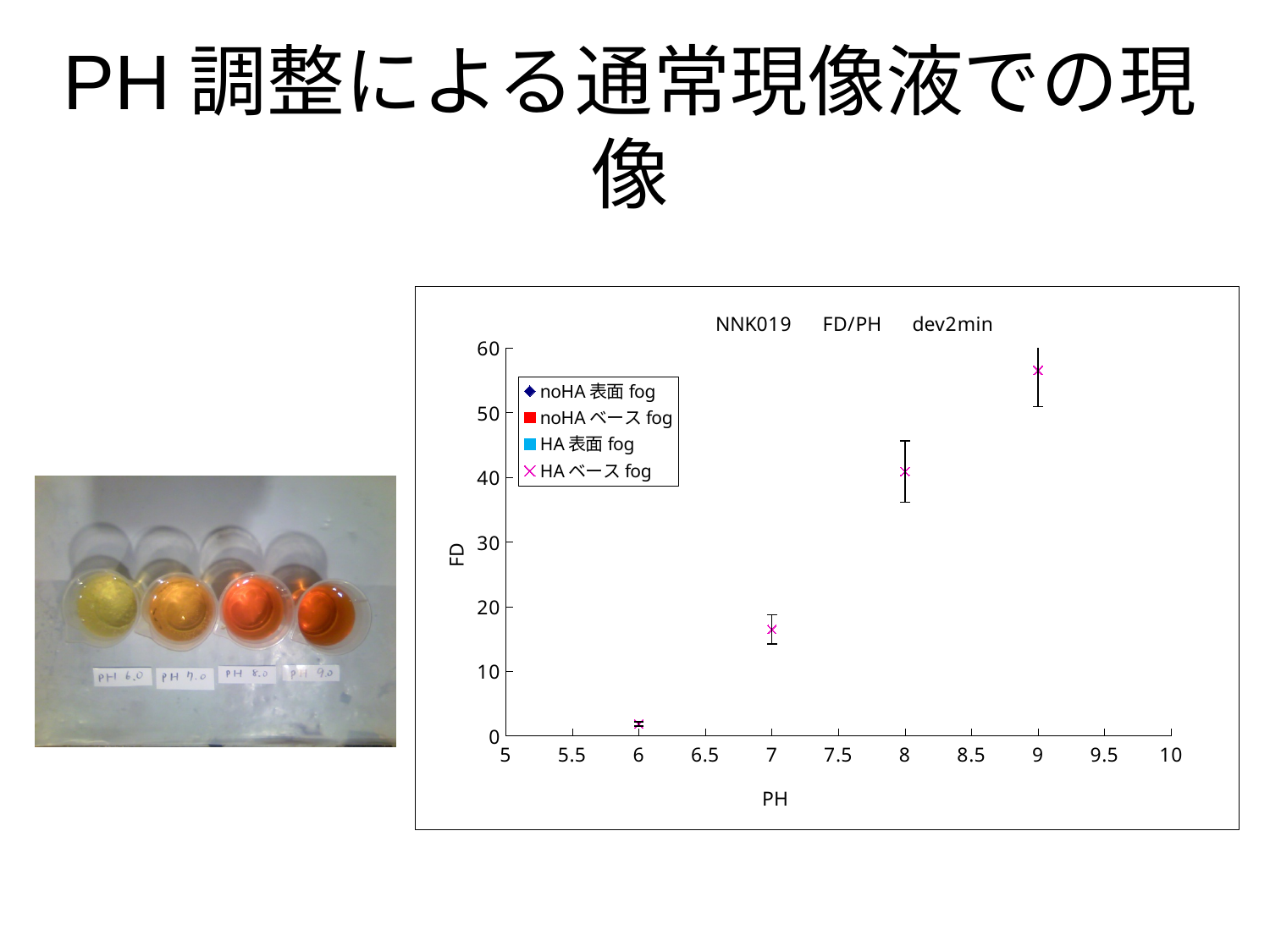
Is the FD value at PH 7 greater or less than 20? less Is the FD value at PH 9 greater or less than 50? greater What is the label of the y axis of the chart? FD At which PH value is the plotted FD lowest? 6 What is the title of the chart? NNK019 FD/PH dev2min At which PH value is the plotted FD highest? 9 Is the FD value at PH 8 greater or less than 30? greater What kind of chart is shown on the slide? scatter chart How many series does the chart's legend list? 4 Does the FD value rise or fall as PH increases along the x axis? rise Which has the larger FD value, PH 7 or PH 8? PH 8